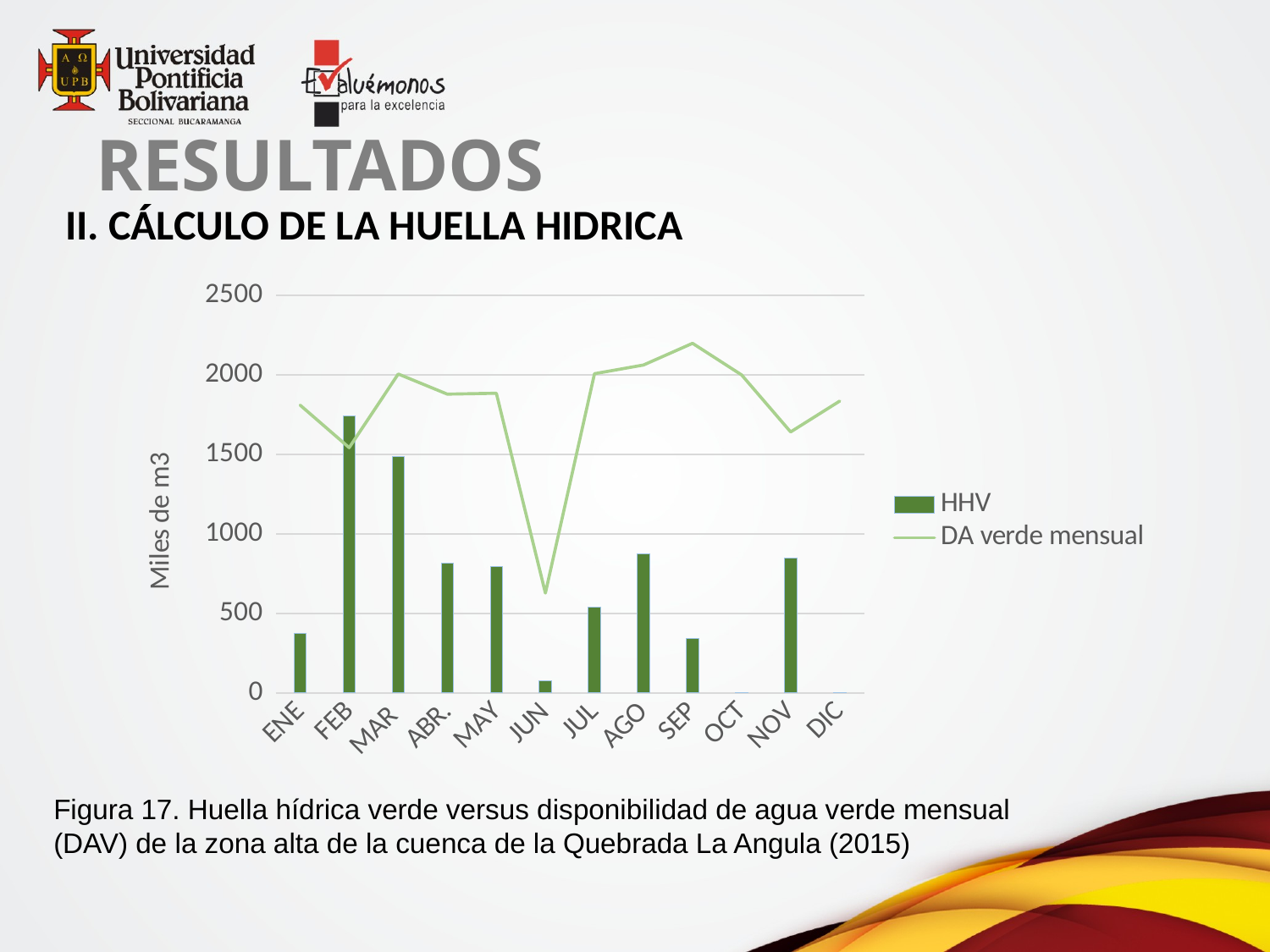
Is the HHV value for FEB greater or less than 1500? greater Which month has a larger HHV value, FEB or MAR? FEB In which month does the DA verde mensual line reach its lowest point? JUN What is the label of the vertical axis? Miles de m3 In which month is the HHV bar the highest? FEB How many series does the legend list? 2 In which month does the DA verde mensual line reach its highest point? SEP Is the DA verde mensual value for SEP greater or less than 2000? greater What kind of chart is shown on the slide? A combined bar and line chart Is the HHV value for JUN greater or less than 500? less Which series is drawn as bars? HHV How many months are shown on the x axis? 12